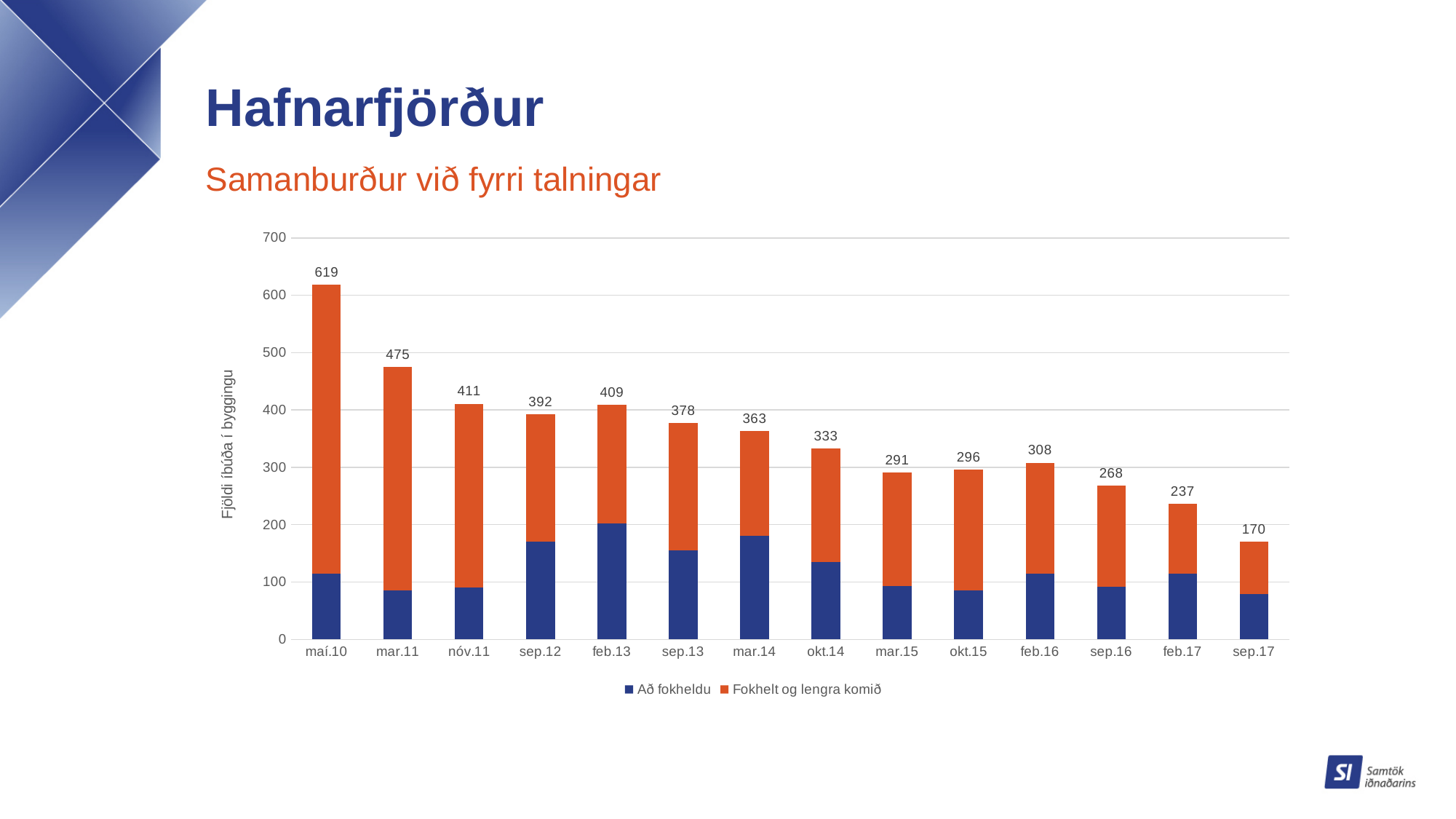
What is the total value labelled for feb.13? 409 Which total is larger, okt.15 or feb.16? feb.16 How many series does the legend list? 2 What kind of chart is shown on the slide? Stacked bar chart Is the 'Að fokheldu' value for sep.17 greater or less than 100? less Which period has the lowest total bar? sep.17 What is the total value labelled above the bar for sep.17? 170 What is the difference between the total for maí.10 and the total for mar.11? 144 Which period has the highest total bar? maí.10 What is the label of the y axis? Fjöldi íbúða í byggingu What is the total number of apartments under construction shown for maí.10? 619 How many time periods are shown on the x axis? 14